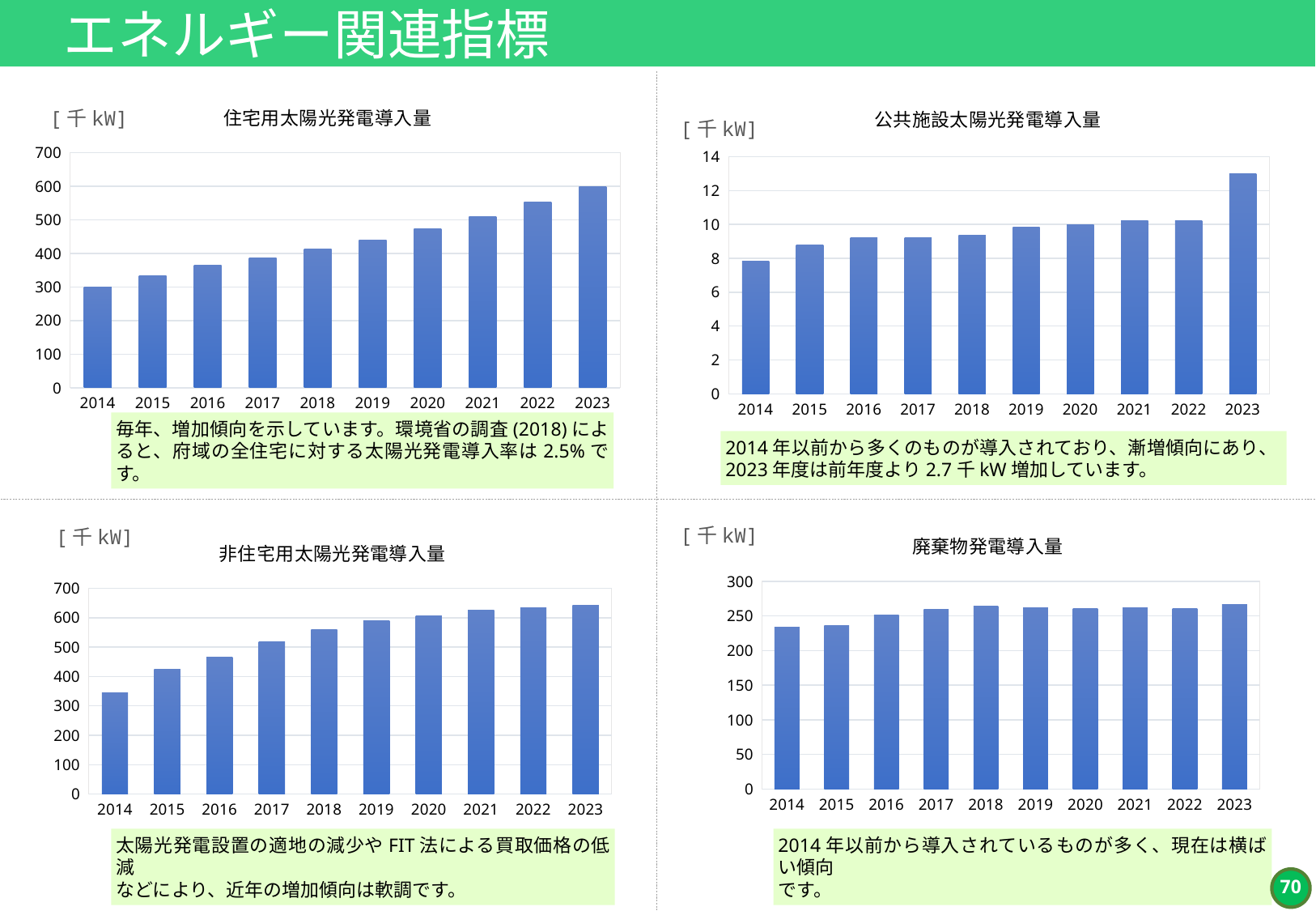
On the 公共施設太陽光発電導入量 chart (top right), which year has the highest value? 2023 On the 非住宅用太陽光発電導入量 chart (bottom left), which year has the lowest value? 2014 On the 公共施設太陽光発電導入量 chart (top right), is the value for 2023 greater or less than 12? greater How many years are plotted on the 住宅用太陽光発電導入量 chart (top left)? 10 On the 住宅用太陽光発電導入量 chart (top left), which year has the highest value? 2023 On the 非住宅用太陽光発電導入量 chart (bottom left), is the value for 2016 greater or less than 500? less On the 住宅用太陽光発電導入量 chart (top left), is the value for 2019 greater or less than 400? greater On the 公共施設太陽光発電導入量 chart (top right), which is larger, the value for 2014 or the value for 2015? 2015 On the 住宅用太陽光発電導入量 chart (top left), do the values rise or fall from 2014 to 2023? rise On the 住宅用太陽光発電導入量 chart (top left), which year has the lowest value? 2014 What kind of chart is the 住宅用太陽光発電導入量 chart (top left)? bar chart